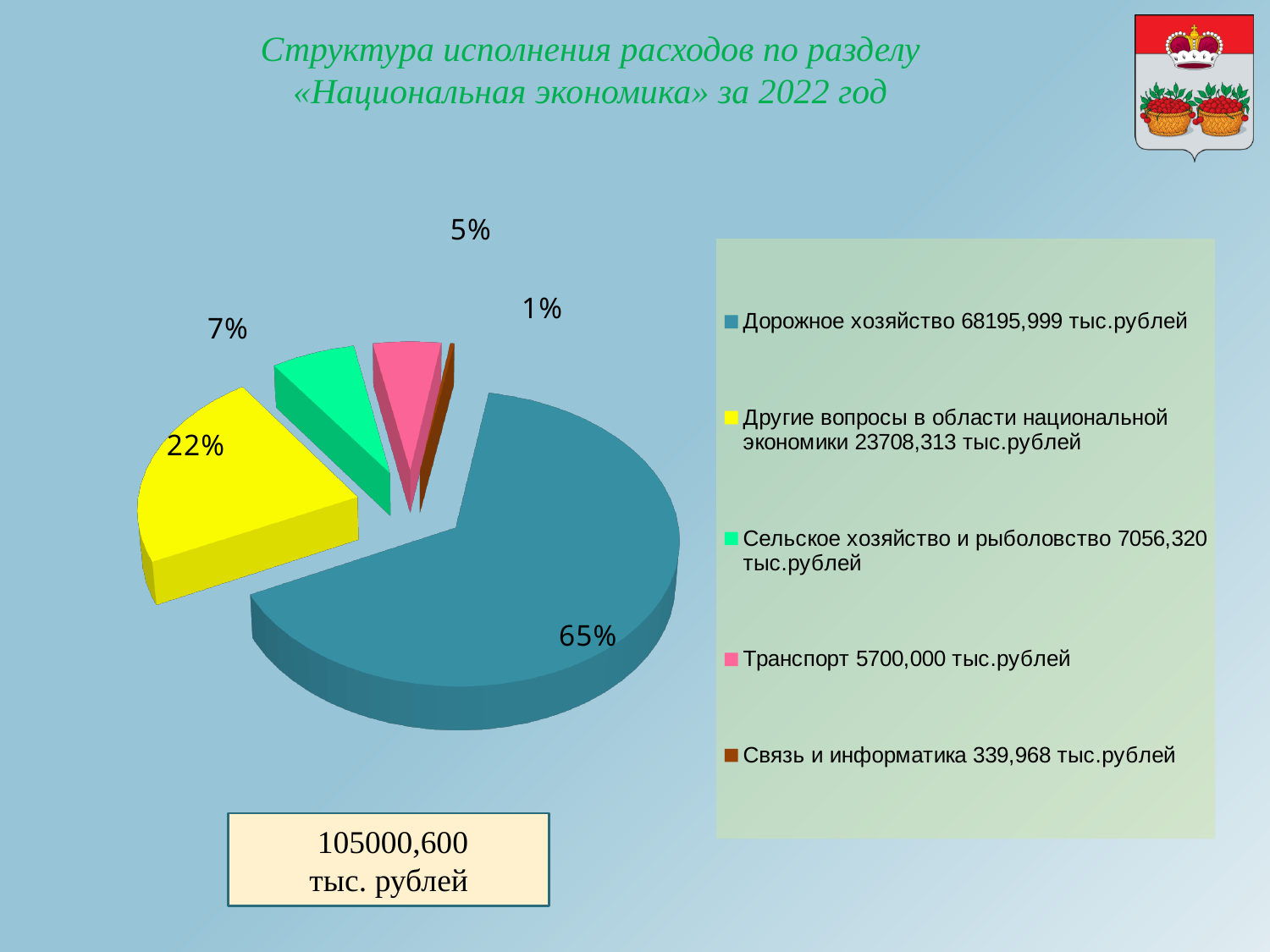
What colour is the slice for Другие вопросы в области национальной экономики? yellow What share of the pie does Связь и информатика take? 1% Which is larger, the share for Сельское хозяйство и рыболовство or the share for Транспорт? Сельское хозяйство и рыболовство What is the value for Транспорт according to the legend? 5700,000 тыс.рублей Which category has the smallest slice of the pie? Связь и информатика What share of the pie does Сельское хозяйство и рыболовство take? 7% Which category has the largest slice of the pie? Дорожное хозяйство What share of the pie does Транспорт take? 5% How many slices does the pie chart have? 5 What kind of chart is shown on the slide? pie chart